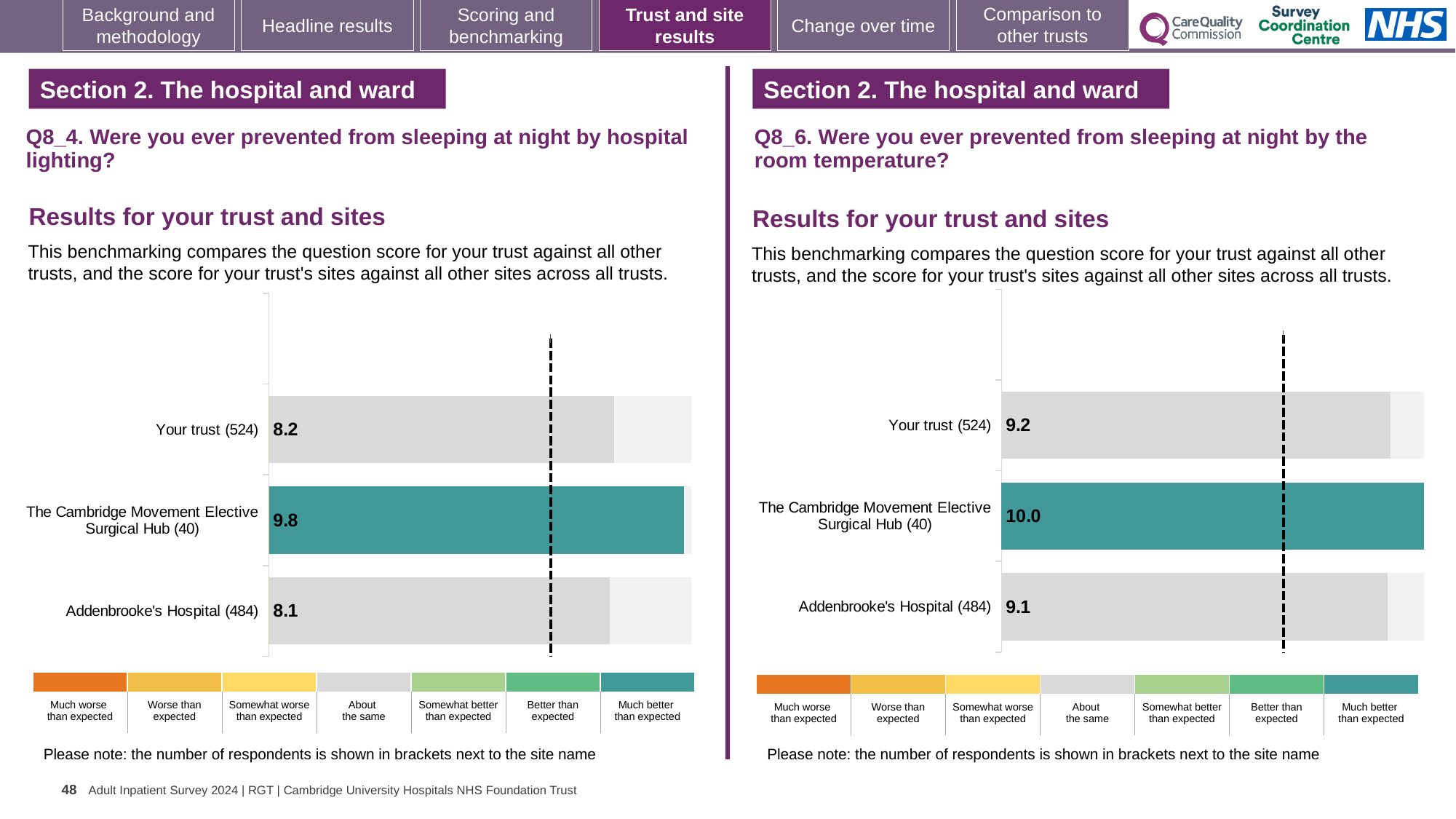
On the Q8_6 chart (room temperature), what is the score for The Cambridge Movement Elective Surgical Hub (40)? 10.0 How many bars are plotted on the Q8_4 chart (hospital lighting)? 3 On the Q8_6 chart (room temperature), what is the score for Your trust (524)? 9.2 On the Q8_4 chart (hospital lighting), what is the score for Addenbrooke's Hospital (484)? 8.1 On the Q8_4 chart (hospital lighting), what is the score for The Cambridge Movement Elective Surgical Hub (40)? 9.8 What kind of chart is used on the Q8_6 chart (room temperature)? Bar chart On the Q8_6 chart (room temperature), what is the difference between the scores for The Cambridge Movement Elective Surgical Hub (40) and Your trust (524)? 0.8 On the Q8_4 chart (hospital lighting), what is the difference between the scores for The Cambridge Movement Elective Surgical Hub (40) and Addenbrooke's Hospital (484)? 1.7 On the Q8_4 chart (hospital lighting), what is the score for Your trust (524)? 8.2 On the Q8_6 chart (room temperature), which site or trust has the lowest score? Addenbrooke's Hospital (484) On the Q8_4 chart (hospital lighting), which site or trust has the highest score? The Cambridge Movement Elective Surgical Hub (40) On the Q8_6 chart (room temperature), what is the score for Addenbrooke's Hospital (484)? 9.1